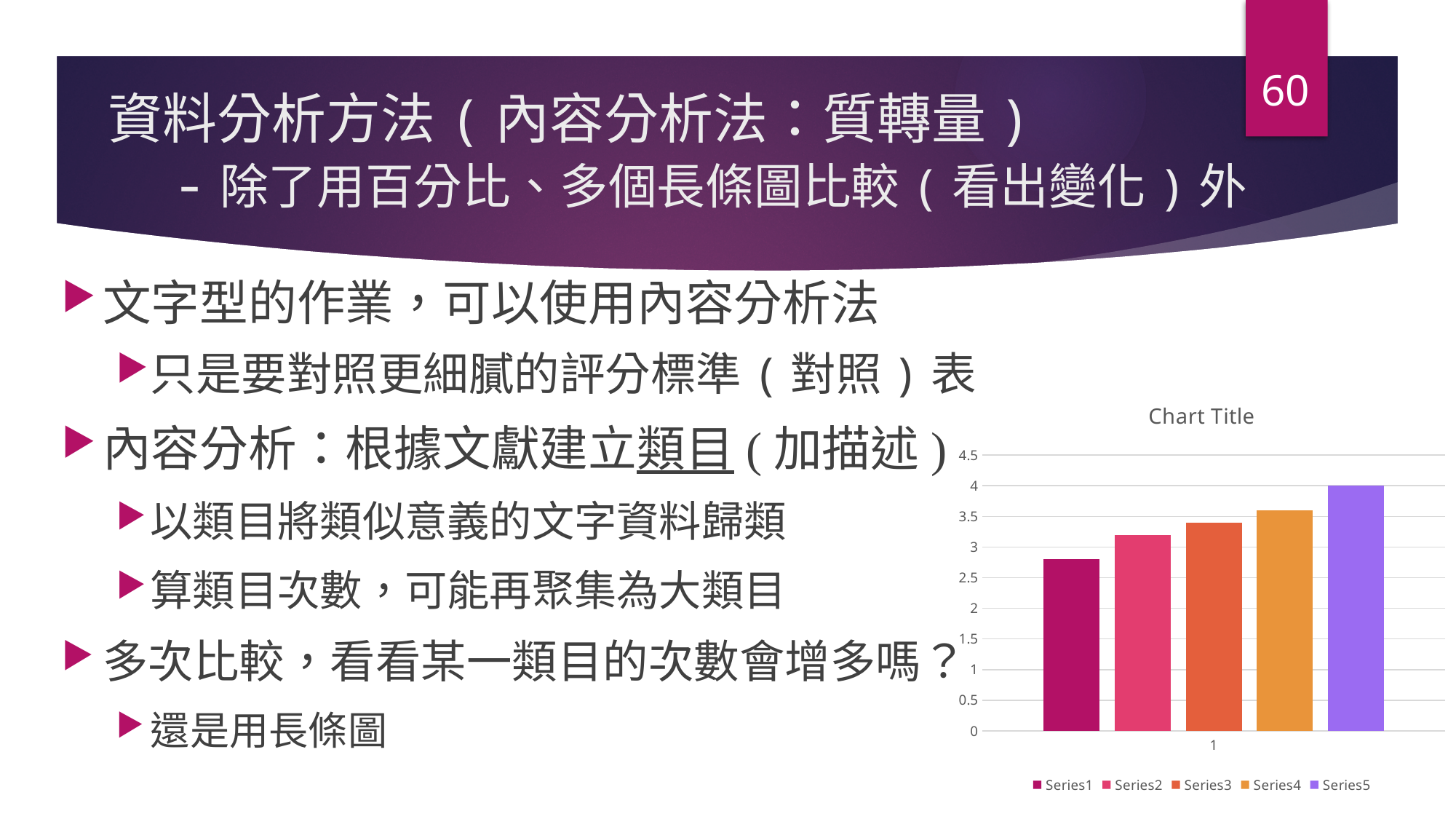
Which series has the tallest bar in the chart? Series5 Is the value for Series4 greater or less than 3.5? greater How many categories are shown on the x axis of the chart? 1 Which is larger, the value for Series2 or the value for Series4? Series4 Do the bars get taller or shorter going from Series1 to Series5? taller What is the title of the chart? Chart Title What type of chart is shown on the slide? bar chart How many series does the chart legend list? 5 What is the value of the Series5 bar? 4 Which series has the shortest bar in the chart? Series1 Is the value for Series1 greater or less than 3? less Is the value for Series2 greater or less than 3? greater